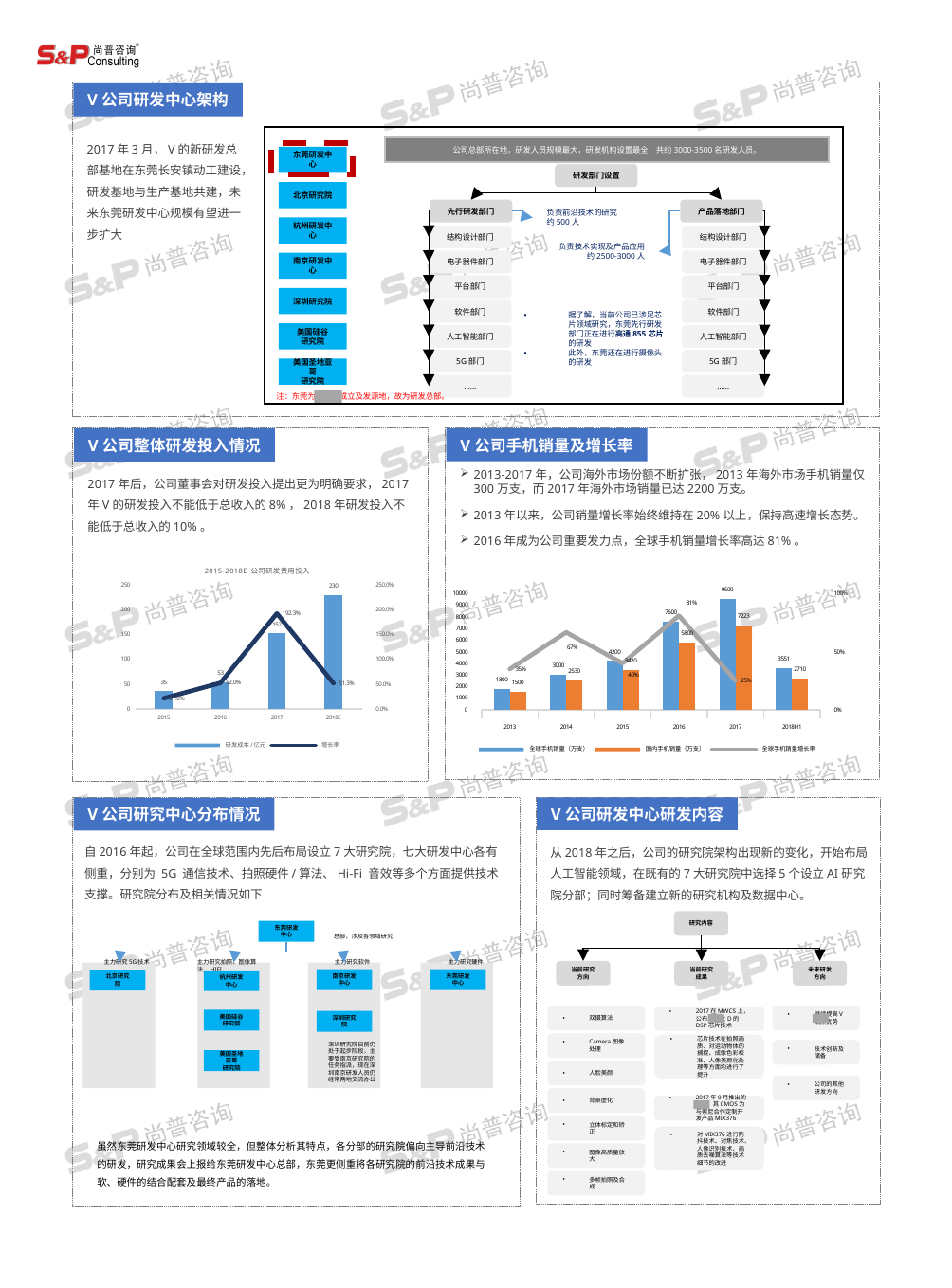
In the V 公司手机销量及增长率 chart, what is the difference between global and domestic phone sales in 2017? 2277 In the chart titled 2015-2018E 公司研发费用投入, what is the R&D spending value for 2017? 152 In the chart titled 2015-2018E 公司研发费用投入, which year has the lowest R&D spending bar? 2015 In the chart titled 2015-2018E 公司研发费用投入, what is the growth rate shown for 2017? 192.3% In the V 公司手机销量及增长率 chart, what is the global phone sales value (全球手机销量) for 2017? 9500 In the chart titled 2015-2018E 公司研发费用投入, what is the difference in R&D spending between 2018E and 2017? 78 In the chart titled 2015-2018E 公司研发费用投入, how many years are shown on the x axis? 4 In the V 公司手机销量及增长率 chart, what is the global sales growth rate for 2016? 81% In the V 公司手机销量及增长率 chart, what is the domestic phone sales value (国内手机销量) for 2016? 5800 In the chart titled 2015-2018E 公司研发费用投入, what is the R&D spending value for 2018E? 230 In the V 公司手机销量及增长率 chart, which year has the highest global phone sales? 2017 In the V 公司手机销量及增长率 chart, how many series does the legend list? 3